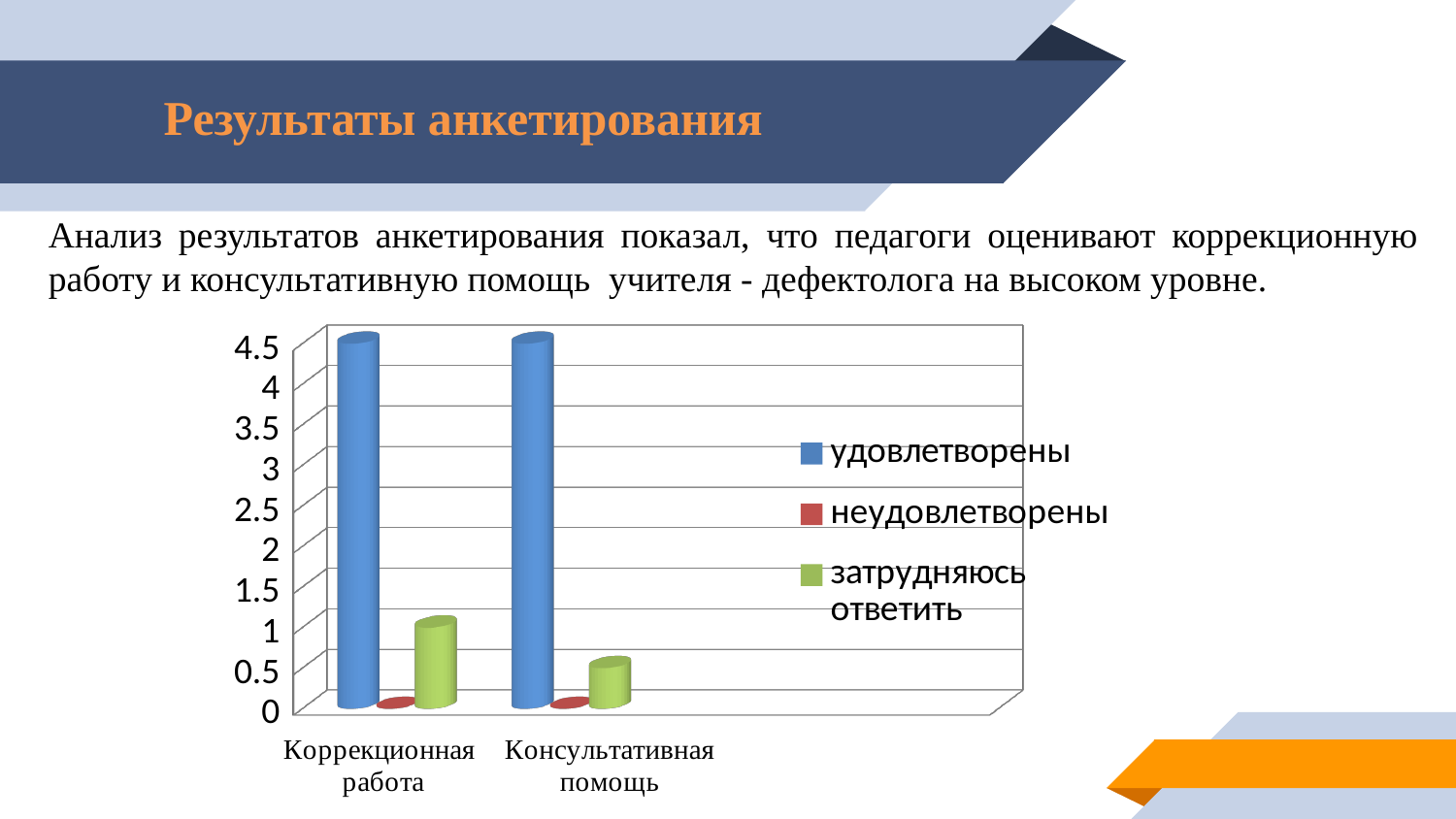
Is the value for затрудняюсь ответить in Консультативная помощь greater or less than 1? less Is the value for затрудняюсь ответить in Коррекционная работа greater or less than 1.5? less Which series has the highest value for Консультативная помощь? удовлетворены For затрудняюсь ответить, which category has the larger value: Коррекционная работа or Консультативная помощь? Коррекционная работа What colour represents the series удовлетворены in the legend? blue What kind of chart is shown on the slide? bar chart Is the value for удовлетворены in Консультативная помощь greater or less than 3? greater How many series does the legend list? 3 How many categories are shown on the x axis? 2 Which series has the lowest value for Коррекционная работа? неудовлетворены In Коррекционная работа, which is larger: удовлетворены or затрудняюсь ответить? удовлетворены